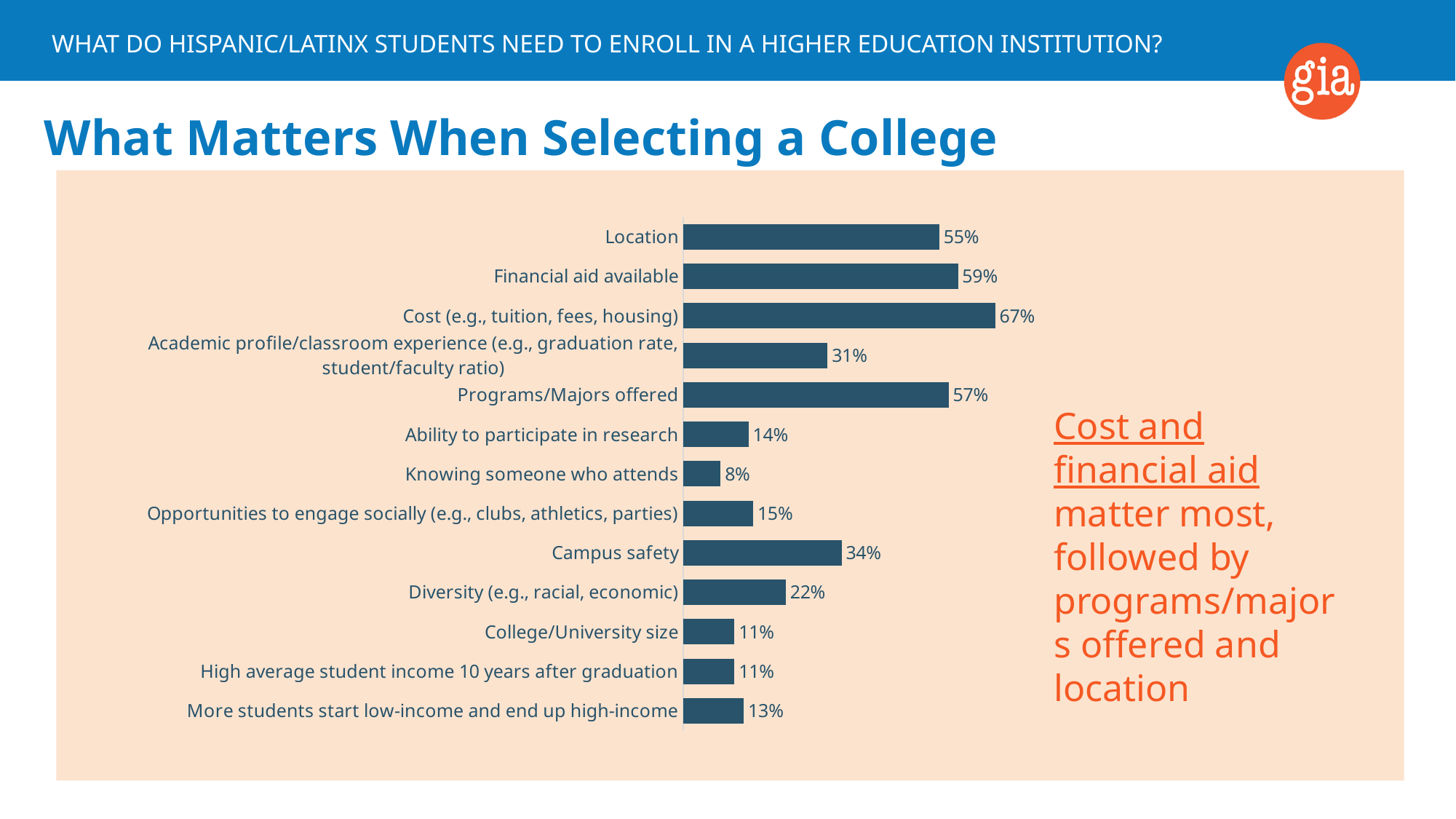
What is the value for Campus safety? 34% Which is larger, the value for Programs/Majors offered or the value for Location? Programs/Majors offered What is the title of the slide above the chart? What Matters When Selecting a College What is the value for Knowing someone who attends? 8% What is the difference between the values for Campus safety and Diversity (e.g., racial, economic)? 12% What percentage of students said Cost (e.g., tuition, fees, housing) matters when selecting a college? 67% What kind of chart is shown on the slide? Bar chart How many categories are shown in the chart? 13 What is the value for Financial aid available? 59% What is the difference between the values for Cost (e.g., tuition, fees, housing) and Location? 12% Which category has the lowest value? Knowing someone who attends Which category has the highest value? Cost (e.g., tuition, fees, housing)